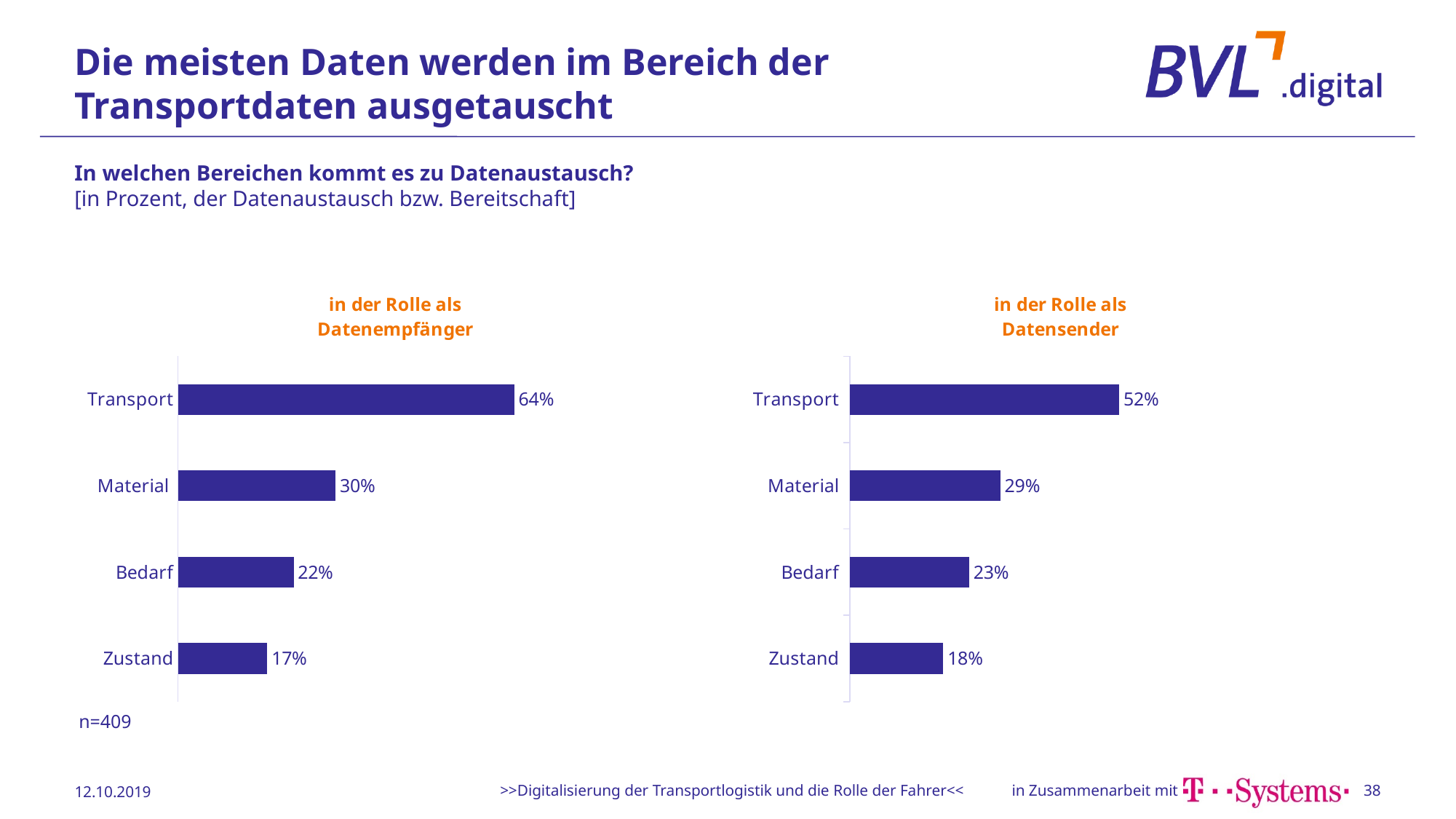
In the 'in der Rolle als Datenempfänger' chart, which category has the highest value? Transport In the 'in der Rolle als Datensender' chart, what is the value for Material? 29% In the 'in der Rolle als Datenempfänger' chart, what is the value for Transport? 64% What sample size (n) is stated below the charts? n=409 What type of chart is the 'in der Rolle als Datensender' chart? Bar chart In the 'in der Rolle als Datensender' chart, do the values rise or fall from Transport down to Zustand? Fall In the 'in der Rolle als Datensender' chart, which category has the lowest value? Zustand In the 'in der Rolle als Datensender' chart, what is the difference between the values for Bedarf and Zustand? 5% Which is larger: the value for Transport in the 'in der Rolle als Datenempfänger' chart or the value for Transport in the 'in der Rolle als Datensender' chart? Datenempfänger (64%) In the 'in der Rolle als Datenempfänger' chart, how many categories are shown? 4 In the 'in der Rolle als Datenempfänger' chart, what is the difference between the values for Transport and Material? 34% In the 'in der Rolle als Datensender' chart, what is the value for Zustand? 18%